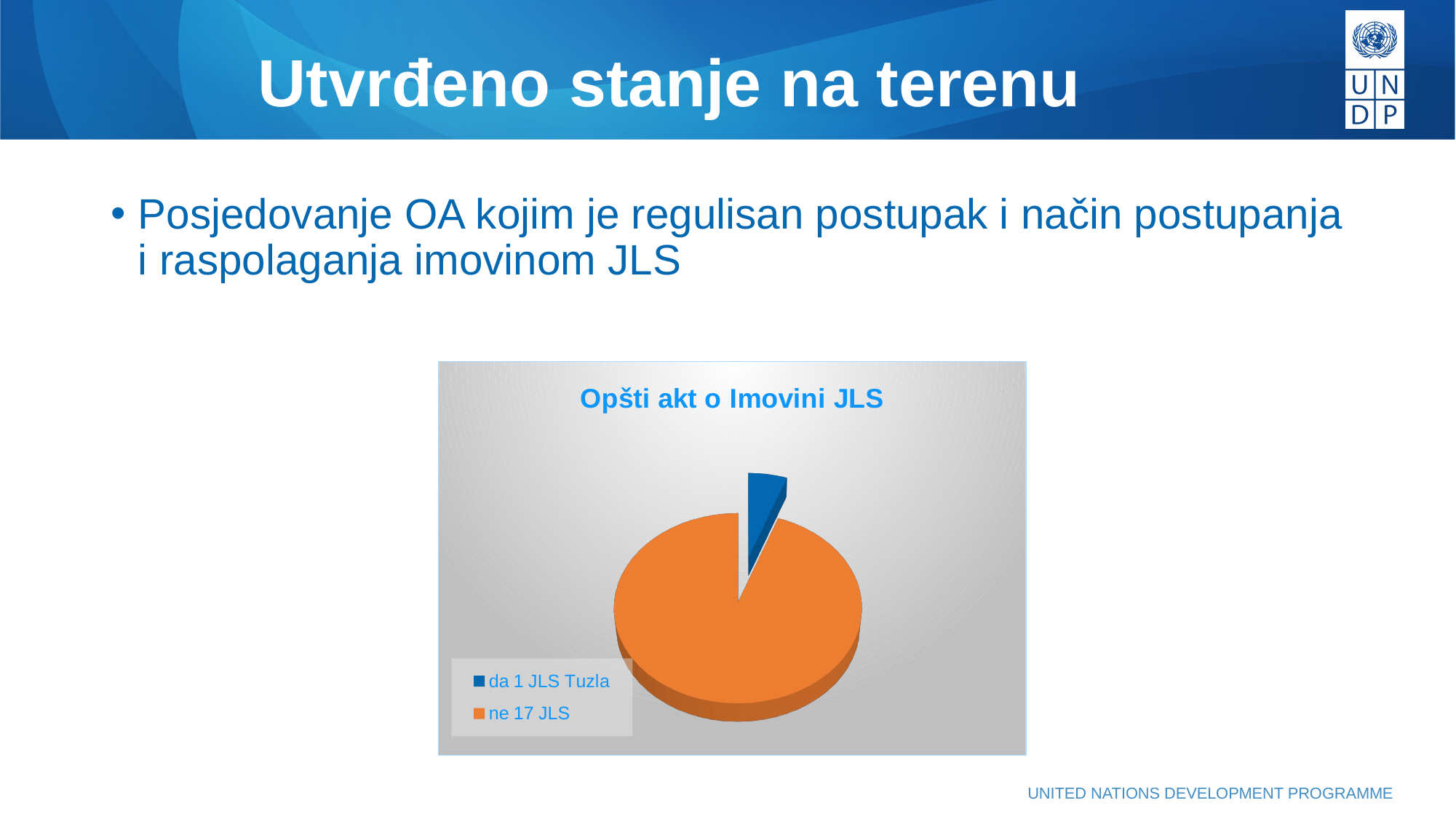
According to the legend, how many JLS answered "ne"? 17 What is the difference between the number of JLS answering "ne" and those answering "da"? 16 According to the legend, how many JLS answered "da"? 1 What type of chart is shown on the slide? pie chart Which category has the largest slice of the pie? ne 17 JLS Which is larger, the "da" slice or the "ne" slice? ne How many slices does the pie chart have? 2 What is the total number of JLS represented in the pie chart? 18 What colour is the slice for "da 1 JLS Tuzla"? blue What is the title of the chart? Opšti akt o Imovini JLS How many entries does the chart legend list? 2 Which category has the smallest slice of the pie? da 1 JLS Tuzla